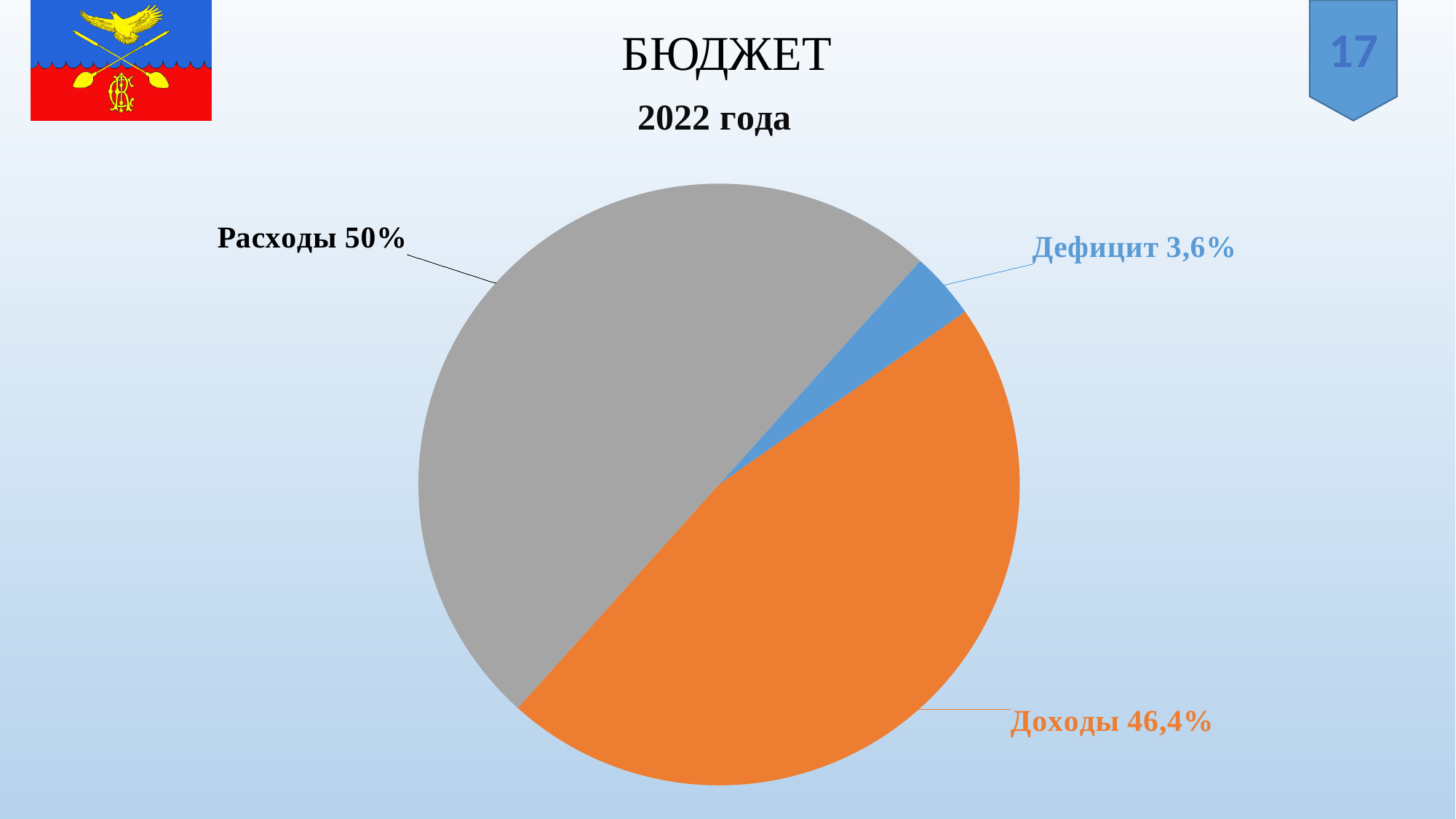
Which is larger, Расходы or Доходы? Расходы Which slice of the pie is the smallest? Дефицит Which slice of the pie is the largest? Расходы What share of the pie does Дефицит have? 3,6% What is the difference between the Доходы and Дефицит shares? 42,8% What is the difference between the Расходы and Доходы shares? 3,6% What share of the pie does Расходы have? 50% What share of the pie does Доходы have? 46,4% What year is shown under the chart title БЮДЖЕТ? 2022 How many slices does the pie chart have? 3 What kind of chart is shown on the slide? pie chart What colour is the Доходы slice? orange